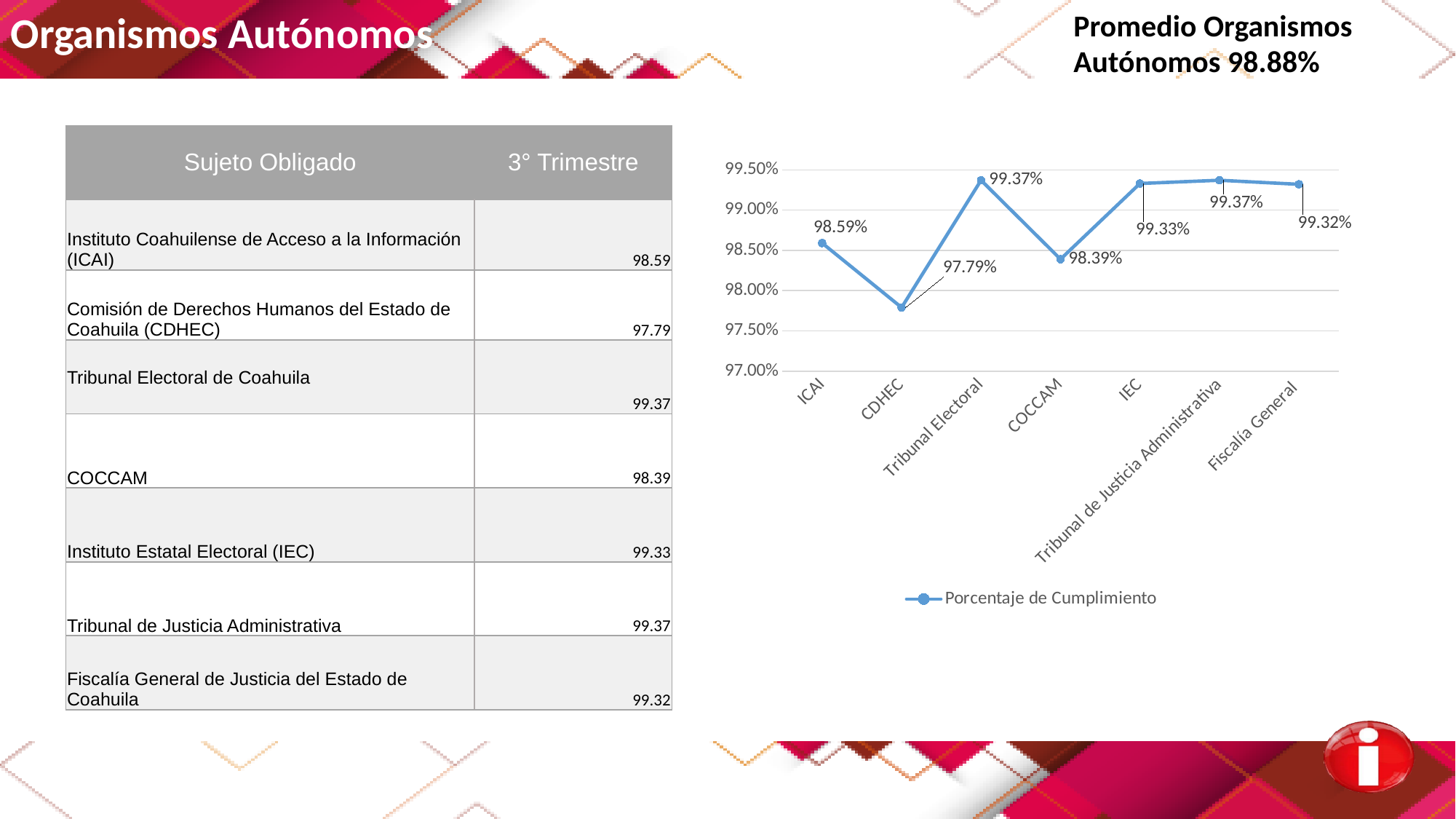
What is the value for Fiscalía General in the line chart? 99.32% What is the value for COCCAM in the line chart? 98.39% Which is larger in the line chart, the value for ICAI or the value for COCCAM? ICAI Is the value for CDHEC in the line chart greater or less than 98.00%? less What series name does the legend of the chart show? Porcentaje de Cumplimiento What kind of chart is shown on the slide? line chart What is the value for ICAI in the line chart? 98.59% Which category has the lowest value in the line chart? CDHEC How many categories are plotted on the x axis of the line chart? 7 What is the value for CDHEC in the line chart? 97.79% What is the difference between the values for IEC and COCCAM in the line chart? 0.94% What is the difference between the values for Tribunal Electoral and CDHEC in the line chart? 1.58%